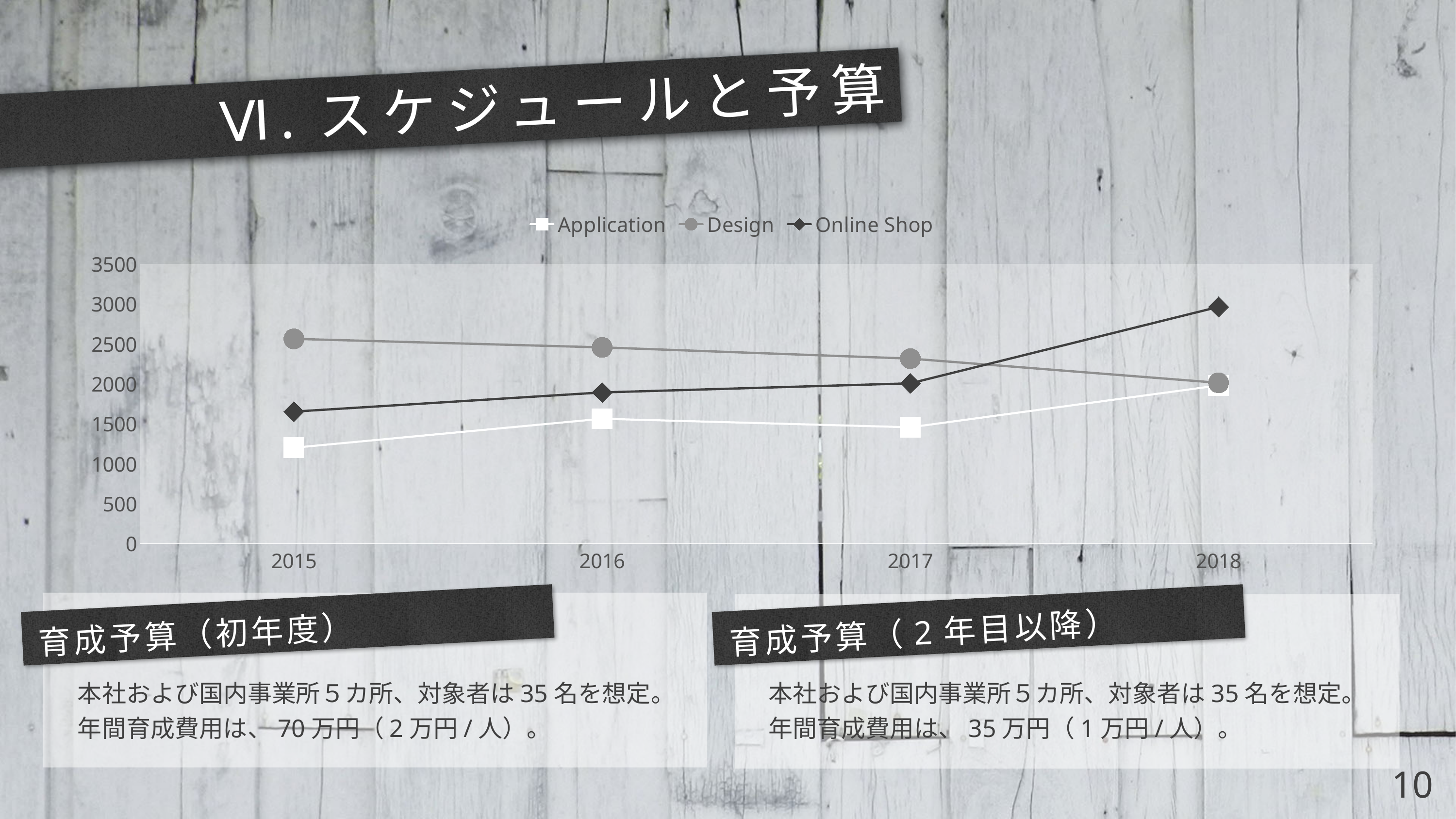
Does the Design series rise or fall from 2015 to 2018? fall Is the value for Application in 2015 greater or less than 1500? less Is the value for Online Shop in 2018 greater or less than 2500? greater How many series does the chart legend list? 3 In 2017, which is larger: Design or Online Shop? Design How many years are plotted along the x axis of the chart? 4 What kind of chart is shown on the slide? line chart Which series has the highest value in 2015? Design Which series has the lowest value in 2015? Application Which series has the highest value in 2018? Online Shop Does the Online Shop series rise or fall from 2015 to 2018? rise Which series is shown with a white line and square markers in the legend? Application